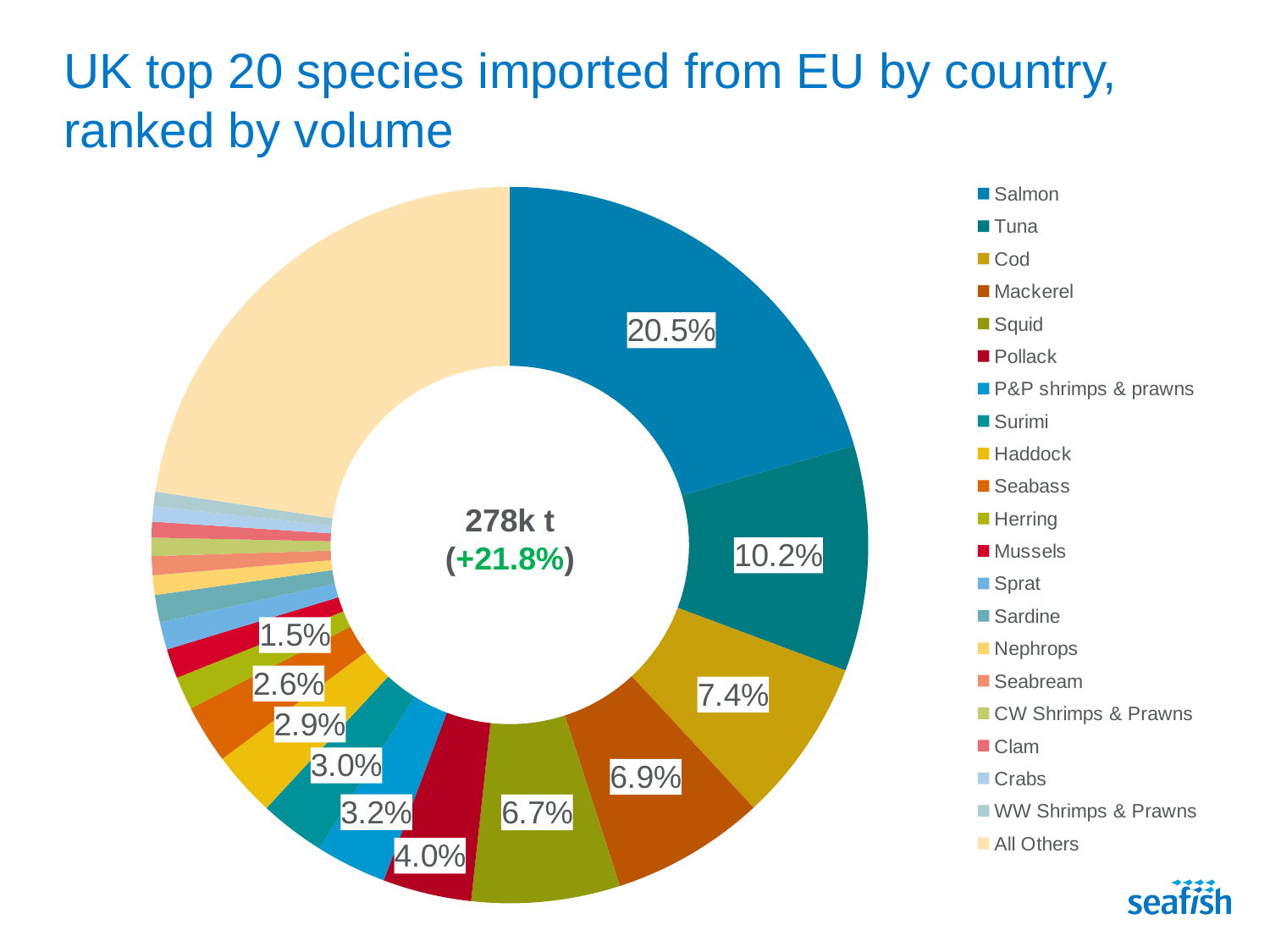
What total volume is printed in the centre of the doughnut chart? 278k t What is the difference in percentage points between the Salmon share and the Tuna share? 10.3 percentage points What kind of chart is shown on the slide? pie chart (doughnut) What share of the pie does Salmon account for? 20.5% What is the value shown for Mackerel? 6.9% How many entries does the legend list? 21 What share of the pie does Tuna account for? 10.2% What is the value shown for Pollack? 4.0% What is the value shown for Squid? 6.7% Which has the larger share, Cod or Mackerel? Cod Which named species has the largest share of the pie? Salmon What is the value shown for Cod? 7.4%